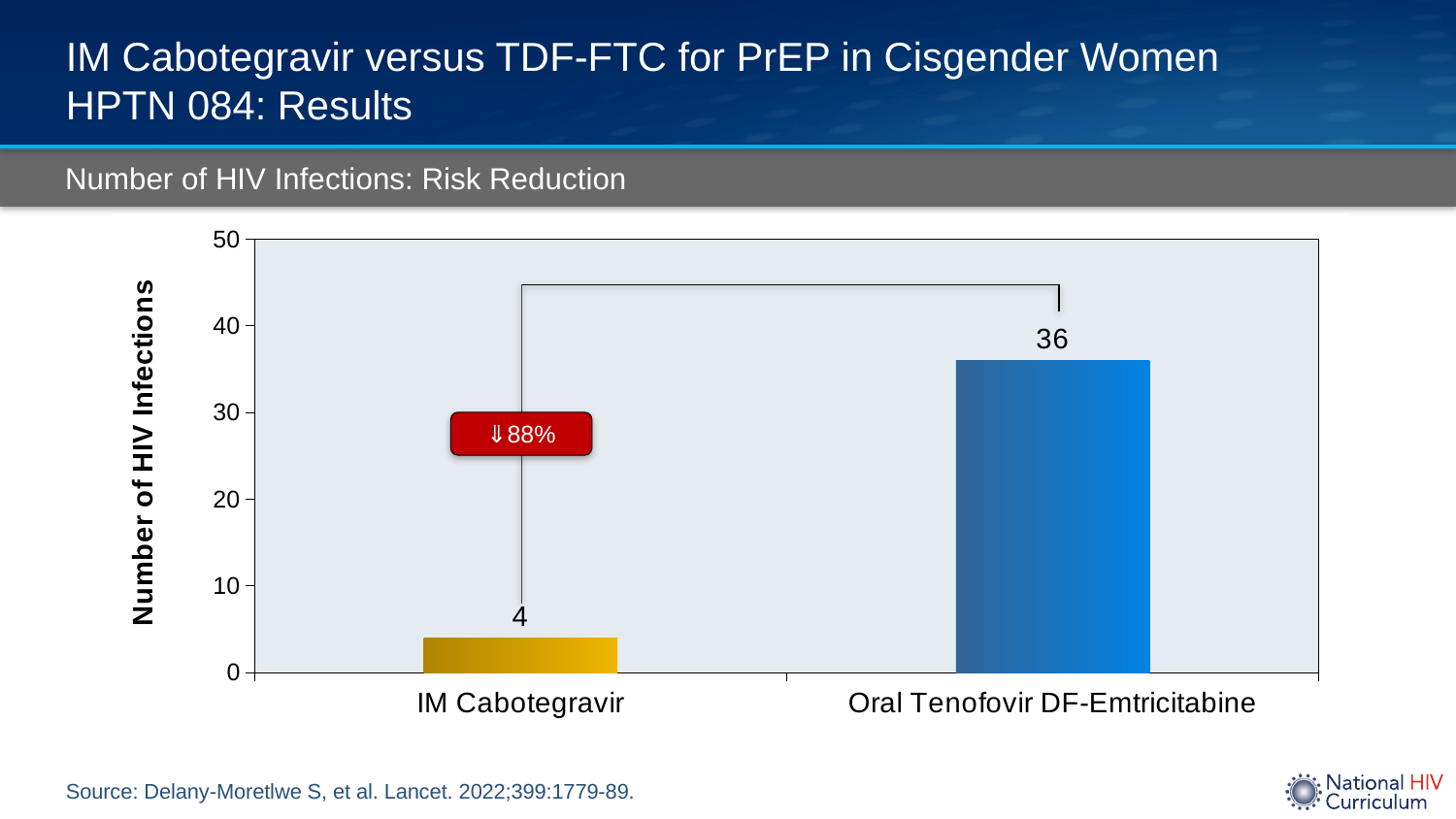
What risk reduction percentage is shown in the red label on the chart? 88% Which category has the highest number of HIV infections? Oral Tenofovir DF-Emtricitabine Is the value for Oral Tenofovir DF-Emtricitabine greater or less than 30? greater What is the number of HIV infections for Oral Tenofovir DF-Emtricitabine? 36 Which has more HIV infections, IM Cabotegravir or Oral Tenofovir DF-Emtricitabine? Oral Tenofovir DF-Emtricitabine Which category has the lowest number of HIV infections? IM Cabotegravir What is the number of HIV infections for IM Cabotegravir? 4 What is the label of the y axis of the chart? Number of HIV Infections Is the value for IM Cabotegravir greater or less than 10? less How many categories are shown on the x axis of the chart? 2 What is the difference in the number of HIV infections between Oral Tenofovir DF-Emtricitabine and IM Cabotegravir? 32 What kind of chart is shown on the slide? Bar chart